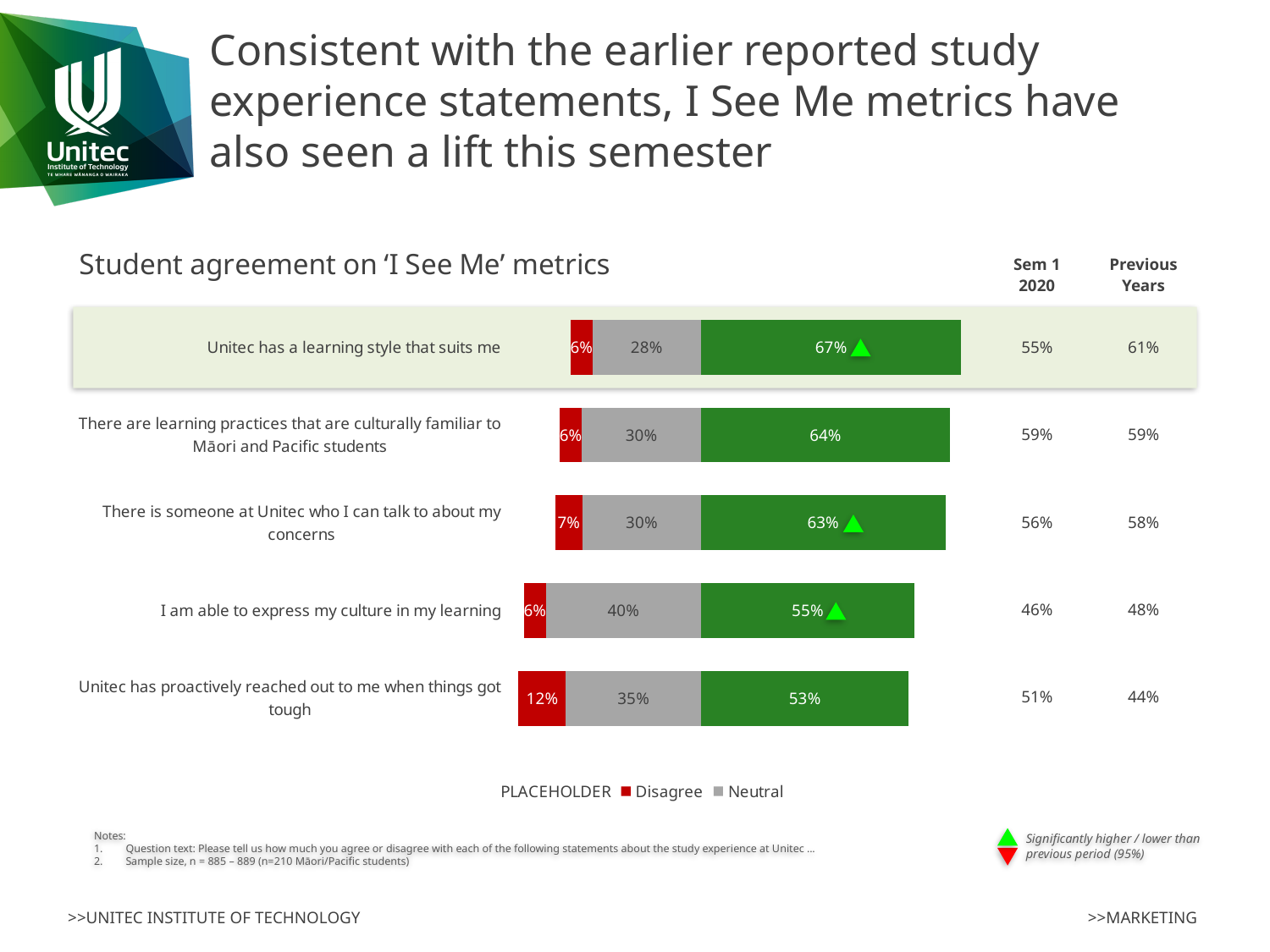
Which statement has the highest Disagree value? Unitec has proactively reached out to me when things got tough What is the difference between the green (agree) values for 'Unitec has a learning style that suits me' and 'Unitec has proactively reached out to me when things got tough'? 14 percentage points What is the Neutral value for the statement 'I am able to express my culture in my learning'? 40% Which statement has the largest green (agree) segment? Unitec has a learning style that suits me What are the entries listed in the chart legend? PLACEHOLDER, Disagree, Neutral How many entries does the chart legend list? 3 What percentage of students agree (green segment) with the statement 'Unitec has a learning style that suits me'? 67% Which statement has the smallest green (agree) segment? Unitec has proactively reached out to me when things got tough What is the Disagree value for the statement 'Unitec has proactively reached out to me when things got tough'? 12% Which statement has a larger Neutral value: 'I am able to express my culture in my learning' or 'Unitec has a learning style that suits me'? I am able to express my culture in my learning What type of chart is used to show student agreement on 'I See Me' metrics? Stacked bar chart How many statements are shown in the chart? 5